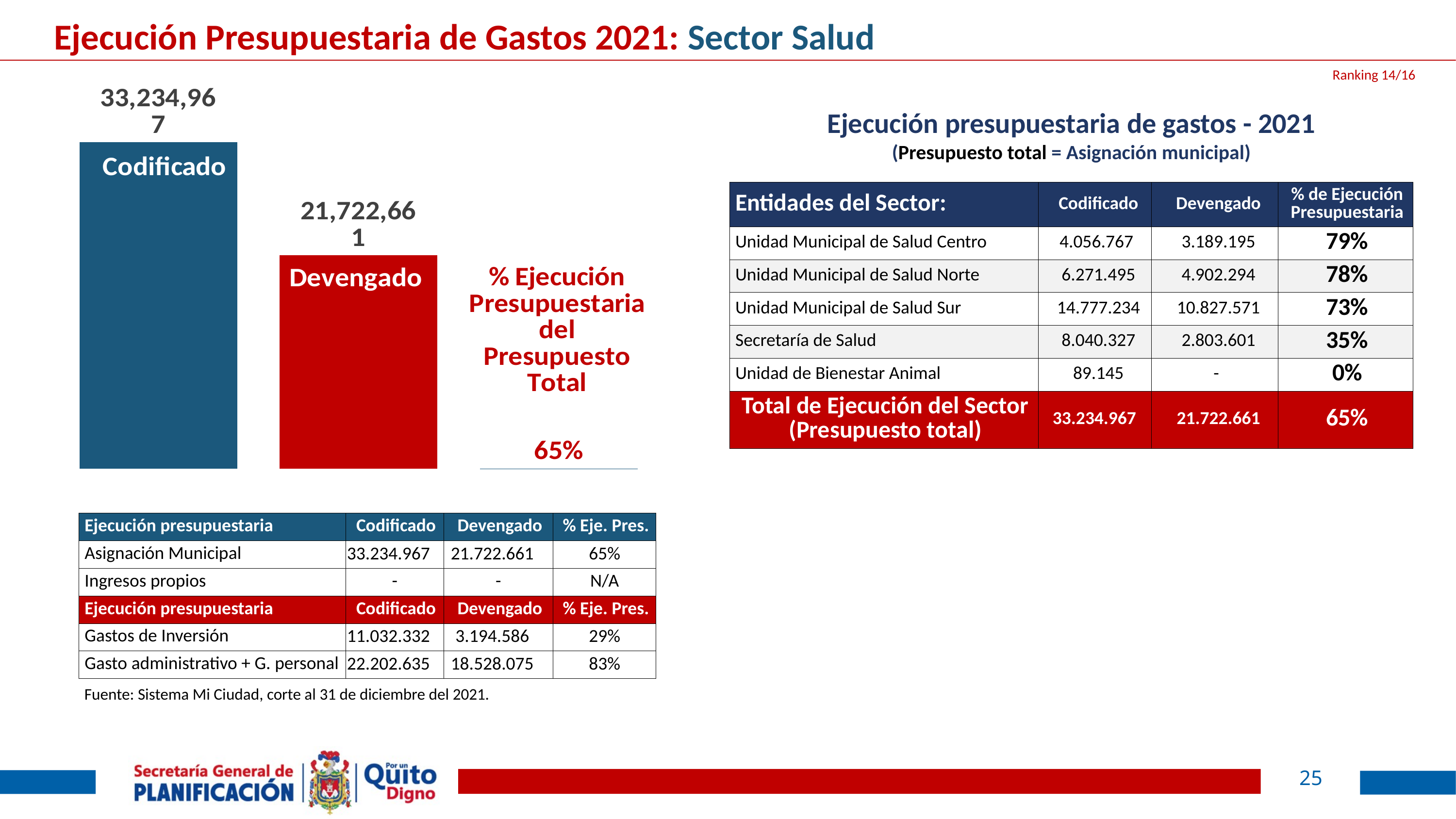
What is the value of the Devengado bar in the bar chart? 21,722,661 What colour is the Codificado bar in the chart? blue Which is larger in the chart, Codificado or Devengado? Codificado How many bars are plotted in the chart? 2 What kind of chart is shown on the left of the slide? bar chart What percentage is shown next to the chart as the % Ejecución Presupuestaria del Presupuesto Total? 65% What colour is the Devengado bar in the chart? red What is the difference between the Codificado and Devengado values in the chart? 11,512,306 What is the value of the Codificado bar in the bar chart? 33,234,967 Which bar in the chart is the lowest? Devengado Which bar in the chart is the highest? Codificado